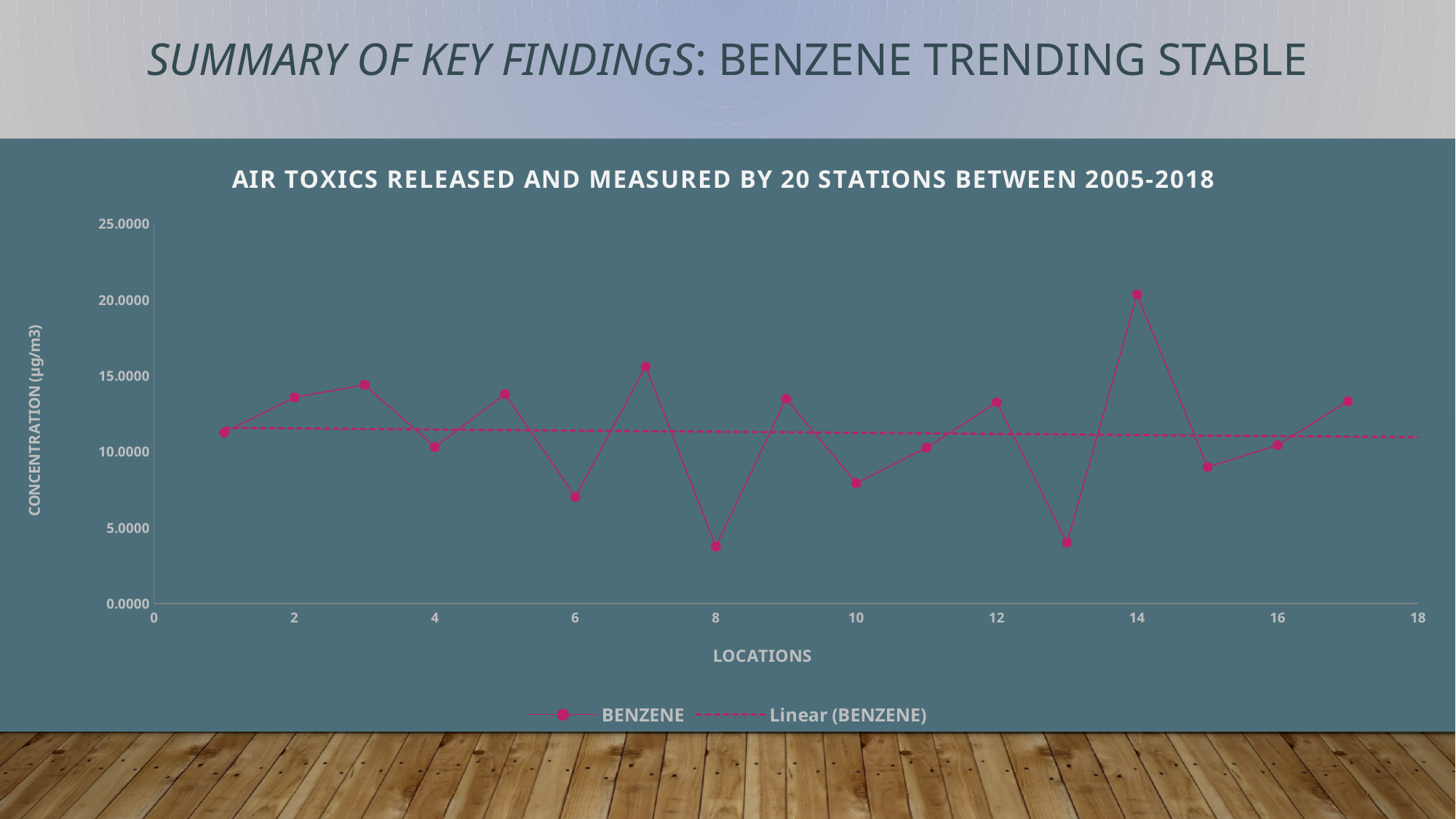
Which location has a higher benzene concentration, location 7 or location 6? Location 7 Is the benzene concentration at location 6 greater or less than 10.0000? less How many data points are plotted for the BENZENE series? 17 What kind of chart is shown on the slide? Line chart What is the label of the vertical axis? Concentration (µg/m3) What is the title of the chart? Air toxics released and measured by 20 stations between 2005-2018 Is the benzene concentration at location 14 greater or less than 15.0000? greater Is the benzene concentration at location 8 greater or less than 5.0000? less At which location is the benzene concentration highest? 14 How many entries does the chart legend list? 2 Which location has a higher benzene concentration, location 14 or location 8? Location 14